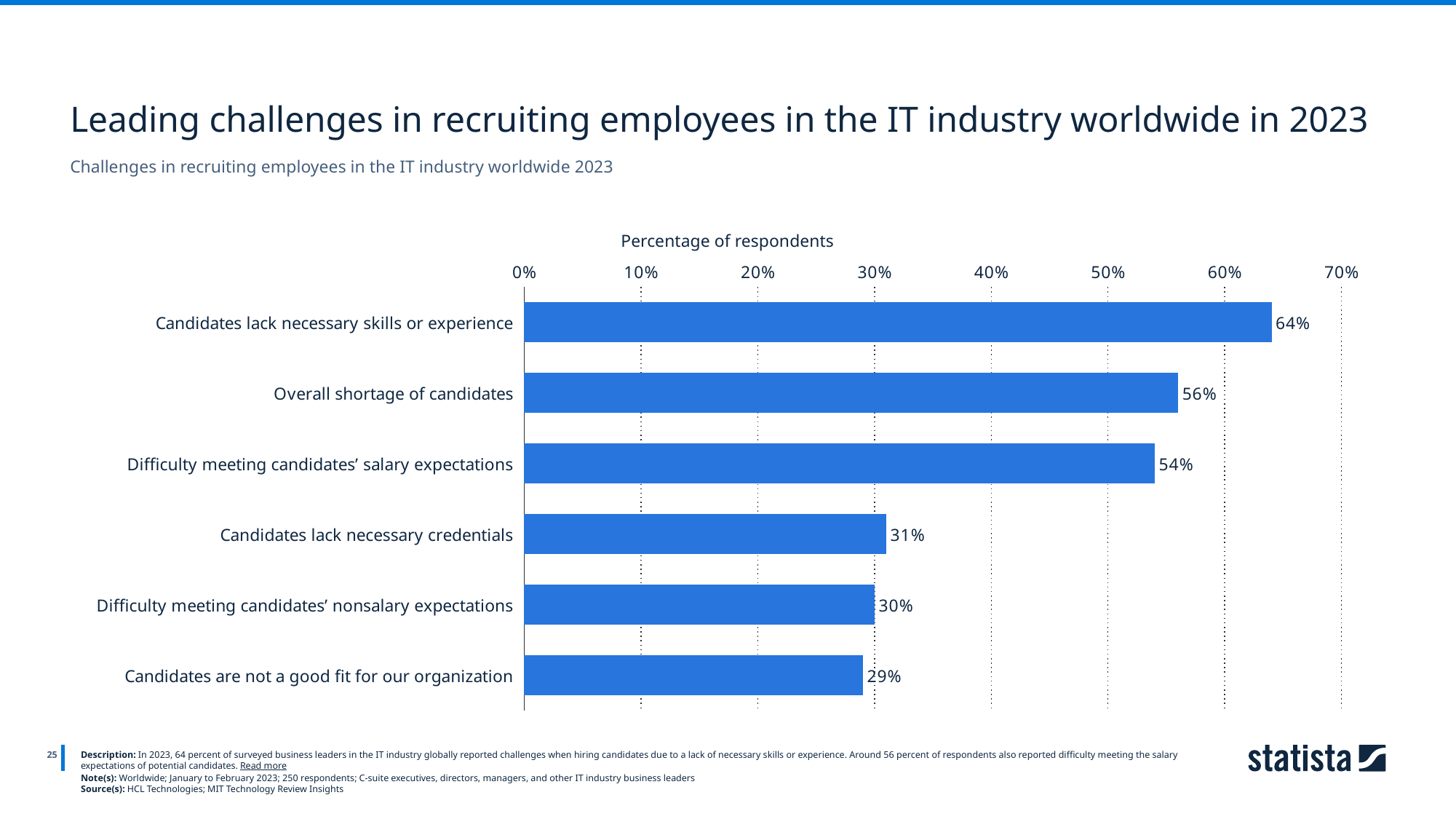
What is the difference in percentage points between 'Candidates lack necessary skills or experience' and 'Overall shortage of candidates'? 8 percentage points Is the value for 'Difficulty meeting candidates' salary expectations' greater or less than 50%? greater What percentage of respondents cited 'Candidates lack necessary skills or experience' as a challenge? 64% How many challenges are shown in the chart? 6 Which challenge has the lowest percentage of respondents? Candidates are not a good fit for our organization Which challenge has the highest percentage of respondents? Candidates lack necessary skills or experience What is the label of the horizontal axis? Percentage of respondents What is the difference between 'Difficulty meeting candidates' salary expectations' and 'Candidates lack necessary credentials'? 23 percentage points What percentage of respondents reported 'Difficulty meeting candidates' nonsalary expectations'? 30% What is the value for 'Overall shortage of candidates'? 56% Which is larger: the value for 'Candidates lack necessary credentials' or 'Candidates are not a good fit for our organization'? Candidates lack necessary credentials What type of chart is shown on the slide? Bar chart